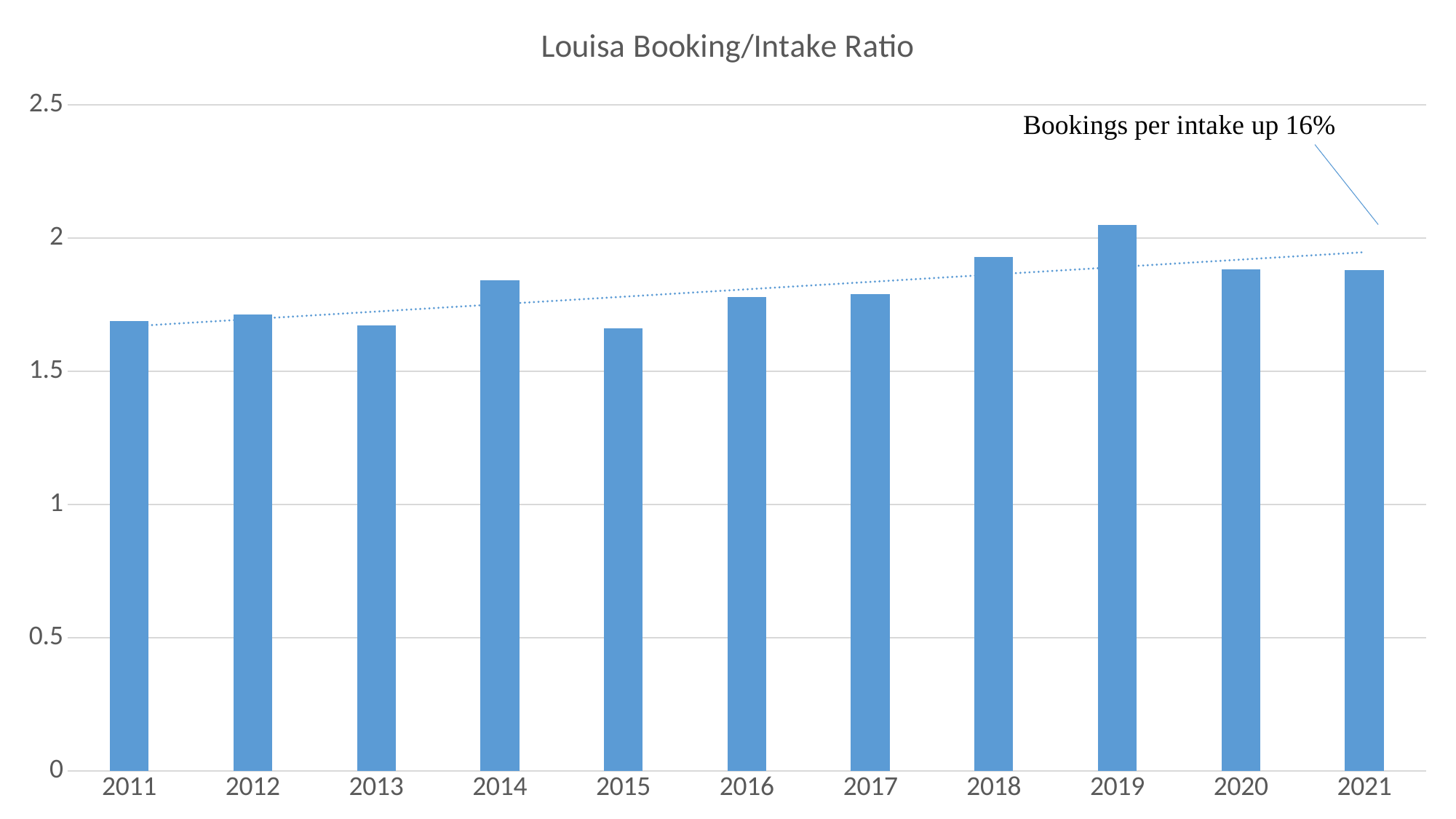
How many years are shown on the x axis of the chart? 11 What kind of chart is shown on the slide? Bar chart Is the value for 2019 greater or less than 1.5? greater Is the value for 2018 greater or less than 2? less Do the values generally rise or fall from 2011 to 2021? rise Which year has the larger value, 2014 or 2013? 2014 What does the annotation on the chart say about bookings per intake? Bookings per intake up 16% Which year has the larger value, 2019 or 2011? 2019 Is the value for 2015 greater or less than 2? less Which year has the highest booking/intake ratio? 2019 What is the title of the chart? Louisa Booking/Intake Ratio